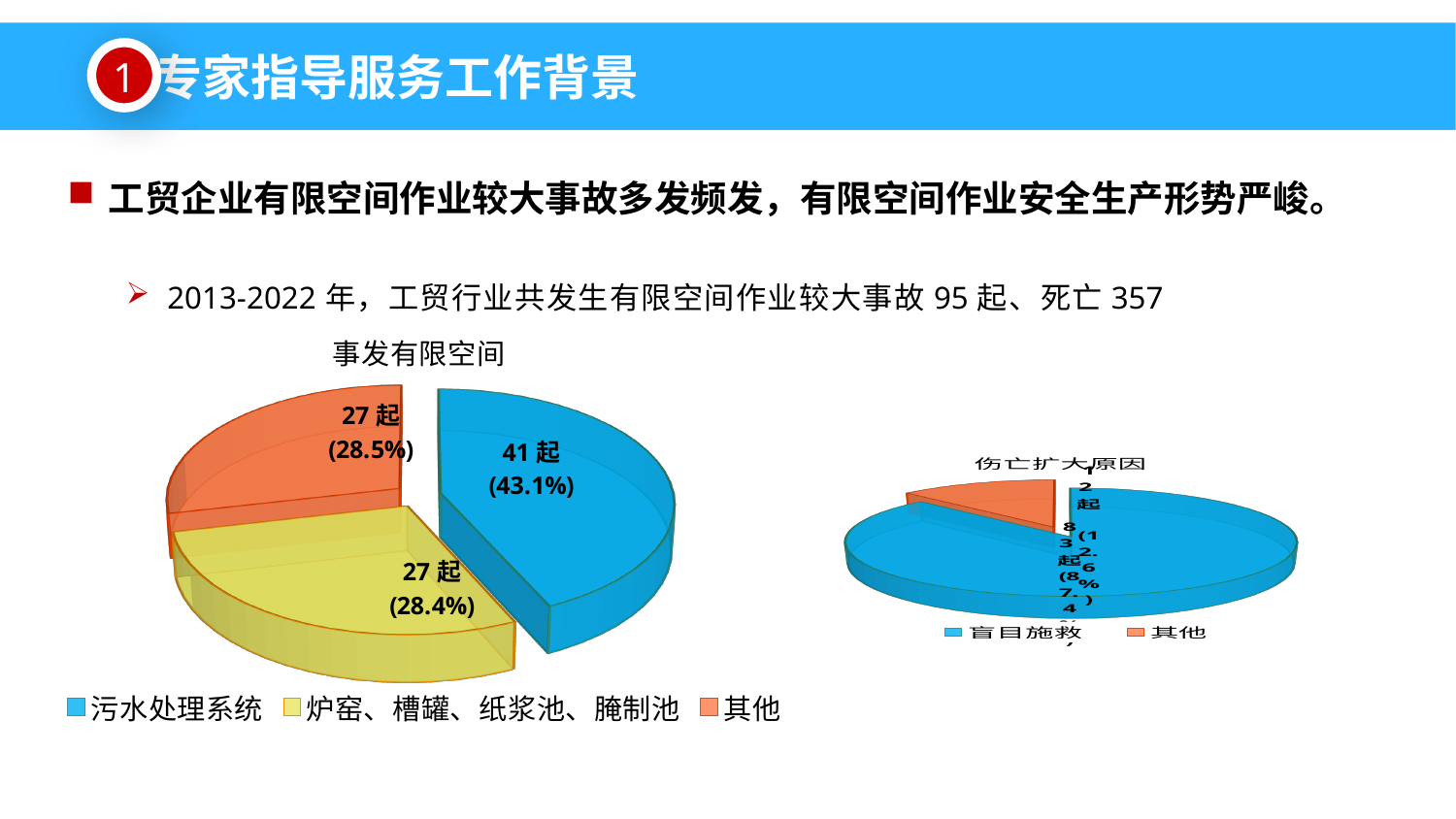
In the chart titled 事发有限空间, which category has the largest slice? 污水处理系统 In the chart titled 事发有限空间, how many cases are shown for 污水处理系统? 41 起 What kind of chart is the chart titled 事发有限空间? pie chart In the chart titled 事发有限空间, how many more cases does 污水处理系统 have than 其他? 14 起 In the chart titled 事发有限空间, what percentage is shown for 其他? 28.5% In the chart titled 事发有限空间, how many cases are shown for 炉窑、槽罐、纸浆池、腌制池? 27 起 In the chart titled 伤亡扩大原因, which slice is larger, 盲目施救 or 其他? 盲目施救 In the chart titled 事发有限空间, which colour represents 炉窑、槽罐、纸浆池、腌制池? yellow In the chart titled 事发有限空间, what is the total number of cases across all slices? 95 起 In the chart titled 事发有限空间, how many categories does the legend list? 3 In the chart titled 事发有限空间, what share of the pie does 污水处理系统 account for? 43.1% In the chart titled 伤亡扩大原因, how many categories does the legend list? 2